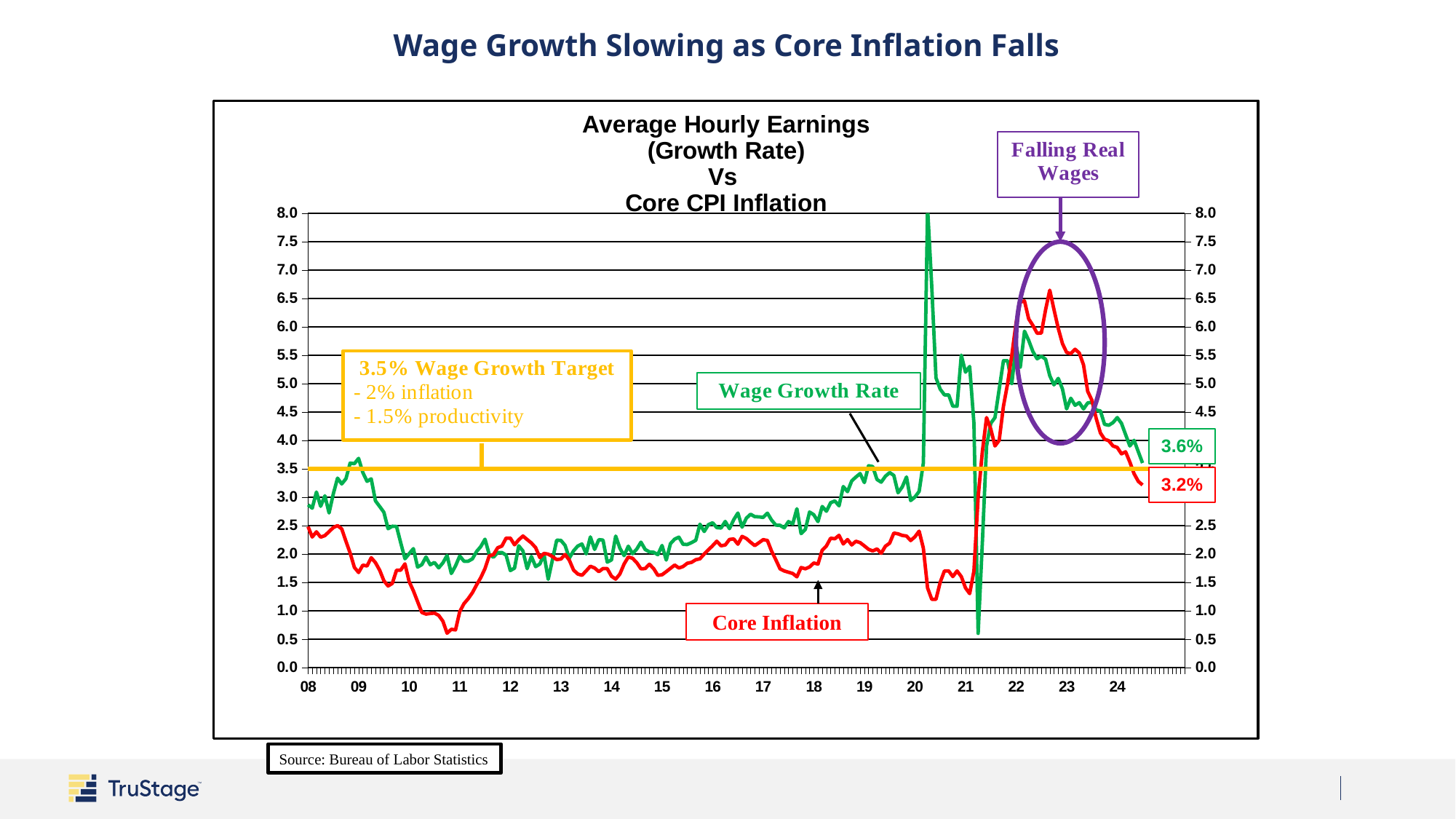
Which series reaches the highest value on the chart? Wage Growth Rate What is the difference between the latest labelled Wage Growth Rate (3.6%) and the latest labelled Core Inflation (3.2%)? 0.4% What is the latest labelled value of the Core Inflation line? 3.2% What value does the horizontal yellow Wage Growth Target line mark? 3.5% Does the Wage Growth Rate rise or fall from 2022 to 2024? fall What does the purple oval on the chart highlight? Falling Real Wages What is the latest labelled value of the Wage Growth Rate line? 3.6% Is the peak of the Core Inflation line in 2022 greater or less than 6.0? greater Is the Wage Growth Rate in 2010 greater or less than 2.5? less What type of chart is shown on the slide? line chart How many data series are plotted on the chart (excluding the target line)? 2 At the end of the chart, which is larger: the labelled Wage Growth Rate or the labelled Core Inflation? Wage Growth Rate